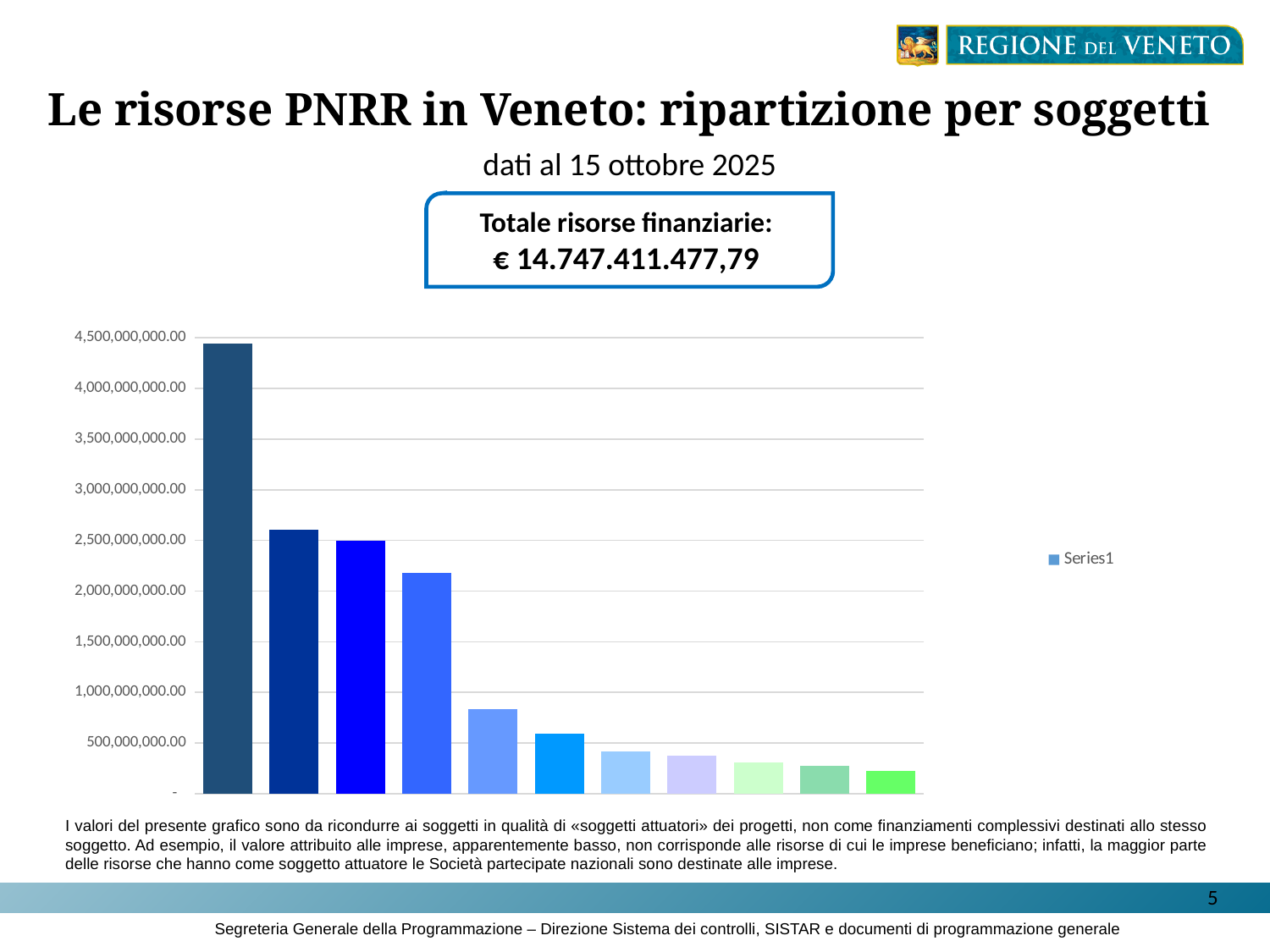
Is the value of the first (leftmost) bar greater or less than 4,000,000,000.00? greater How many bars are plotted in the chart? 11 What is the name of the series shown in the chart legend? Series1 How many series does the chart legend list? 1 Which bar in the chart is the tallest? the first (leftmost) bar Which bar in the chart is the shortest? the last (rightmost) bar What kind of chart is shown on the slide? bar chart Is the value of the fourth bar from the left greater or less than 2,000,000,000.00? greater Is the value of the last (rightmost) bar greater or less than 500,000,000.00? less Do the bar values rise or fall moving from left to right along the x axis? fall